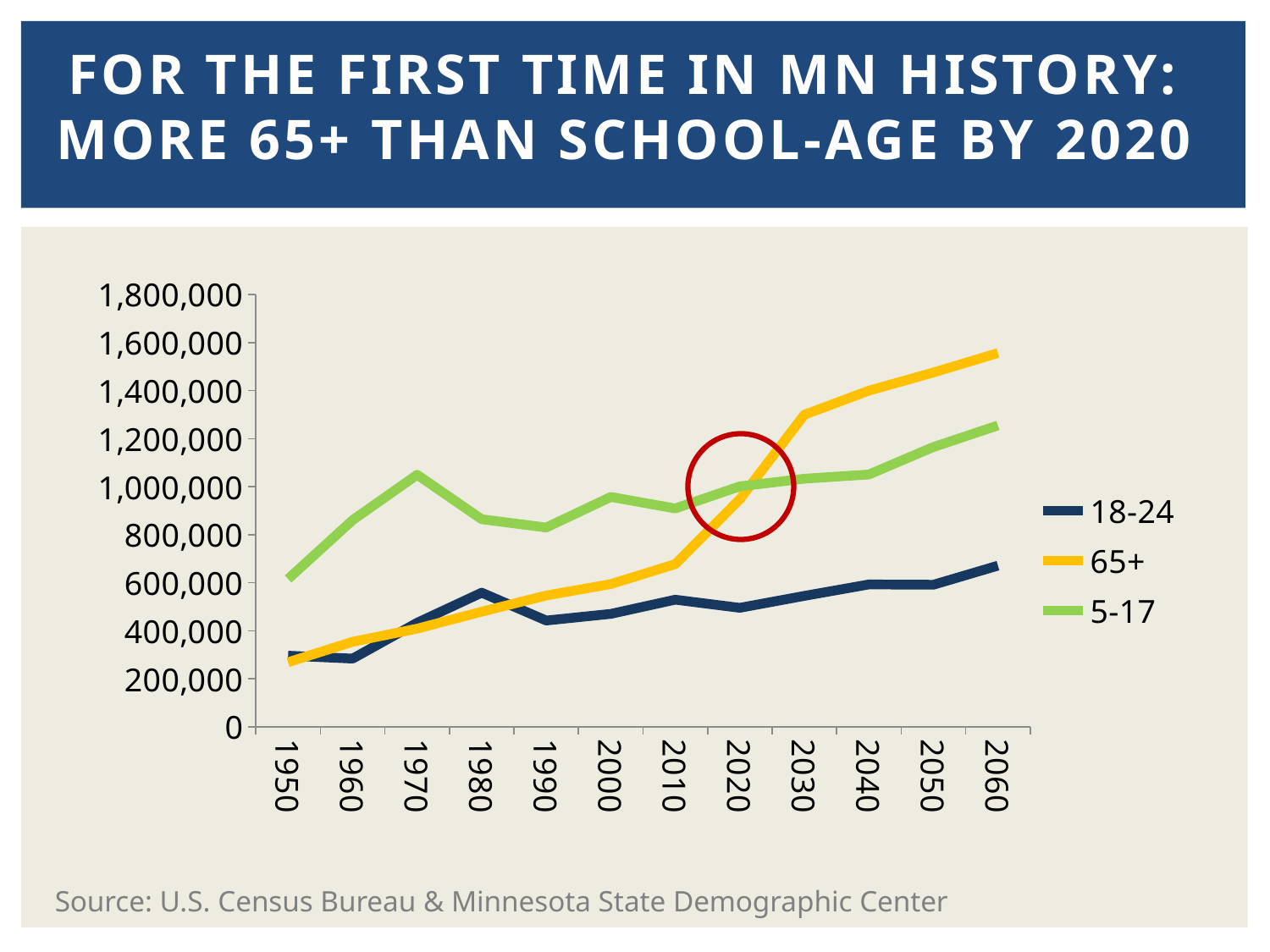
What kind of chart is shown on the slide? line chart How many years are labelled along the x axis? 12 Which series has the lowest value in 2060? 18-24 Which series has the highest value in 2060? 65+ How many series does the legend list? 3 Which series has the highest value in 1990? 5-17 Is the value for 18-24 in 2060 greater or less than 800,000? less Is the value for 65+ in 2060 greater or less than 1,400,000? greater Does the 65+ series rise or fall from 1950 to 2060? rise What are the three entries listed in the legend? 18-24, 65+, 5-17 In 2000, which is larger: the value for 5-17 or the value for 65+? 5-17 In 2040, which is larger: the value for 65+ or the value for 18-24? 65+